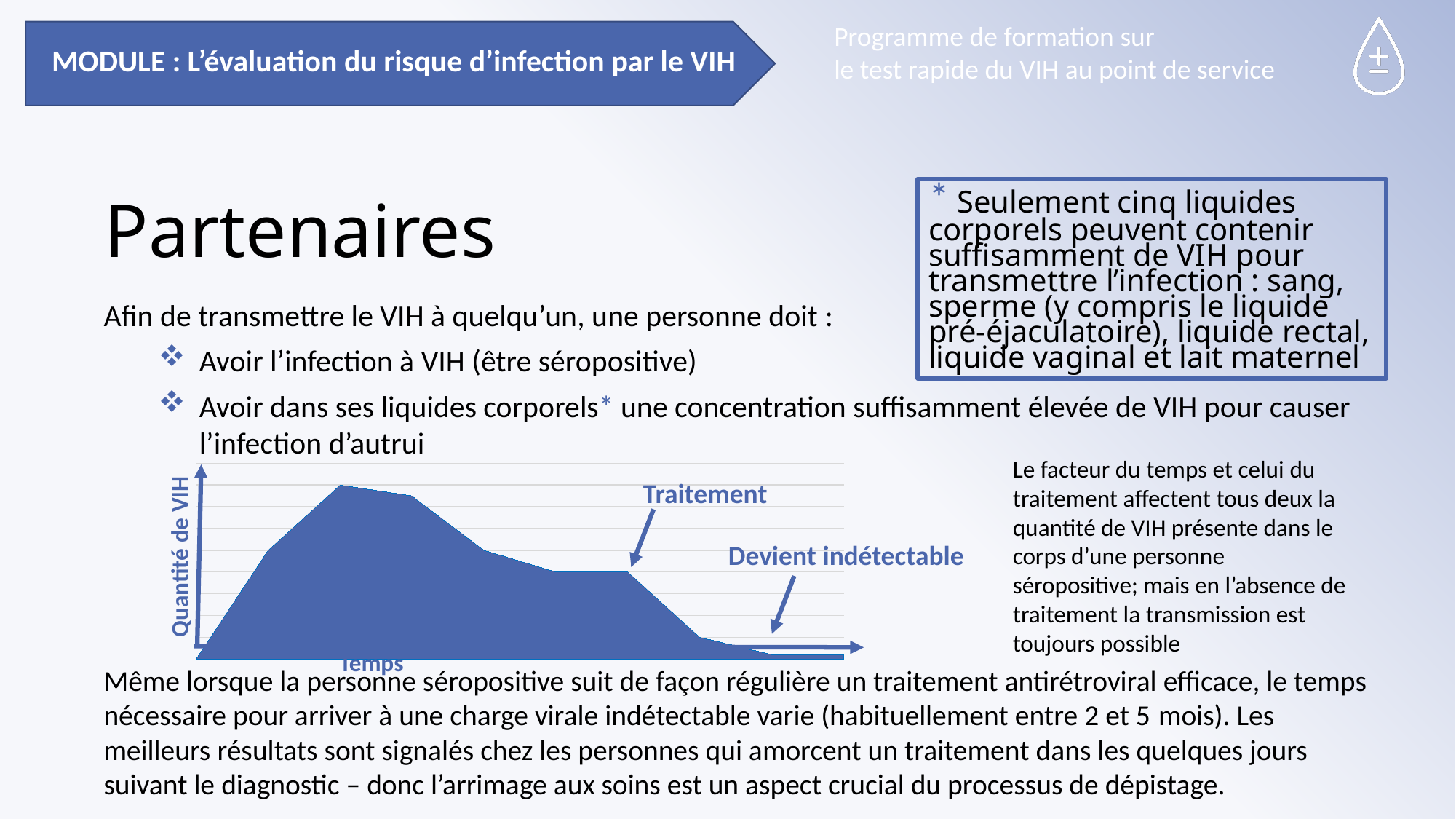
Does the quantity of HIV rise or fall at the start of the chart, along the time axis? Rises Which annotation appears first along the time axis, 'Traitement' or 'Devient indétectable'? Traitement What kind of chart is shown on the slide? Area chart What is the label of the horizontal axis of the chart? Temps After the peak, does the quantity of HIV rise or fall along the time axis? Falls What is the label of the vertical axis of the chart? Quantité de VIH What happens to the quantity of HIV after the point labelled 'Traitement'? It falls How many data series are plotted in the chart? 1 Is the quantity of HIV at the point labelled 'Traitement' higher or lower than at the point labelled 'Devient indétectable'? Higher How many annotated points are marked with arrows on the chart? 2